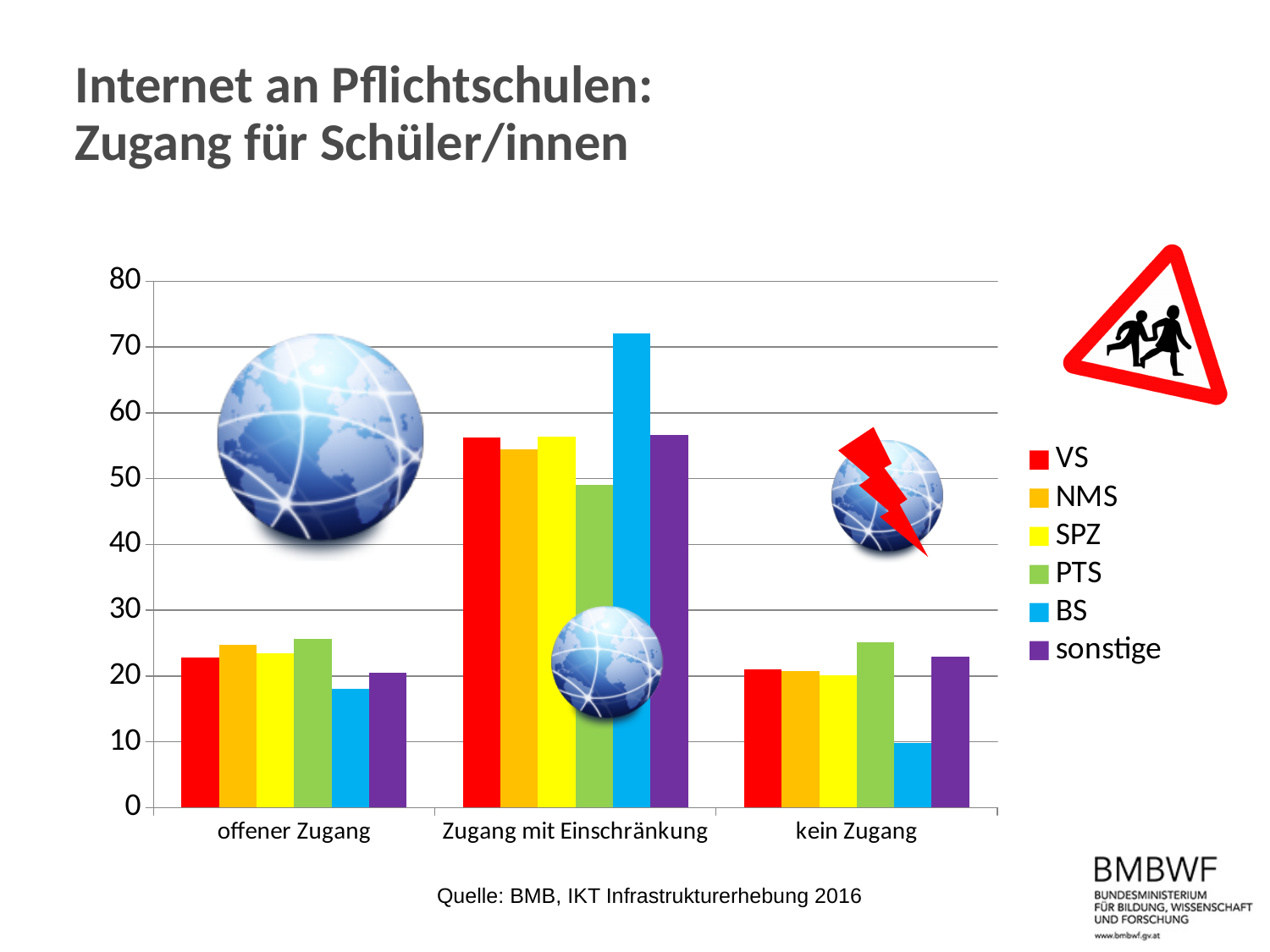
Is the value for BS in "kein Zugang" greater or less than 20? less What kind of chart is shown on the slide? bar chart Is the value for BS in "Zugang mit Einschränkung" greater or less than 70? greater In the "offener Zugang" category, which is larger: PTS or BS? PTS How many series does the legend list? 6 How many categories are shown on the x axis? 3 What is the first entry listed in the legend? VS Which series has the highest value in the "Zugang mit Einschränkung" category? BS Which series has the lowest value in the "offener Zugang" category? BS Which category on the x axis has the highest values overall? Zugang mit Einschränkung Which series has the lowest value in the "kein Zugang" category? BS